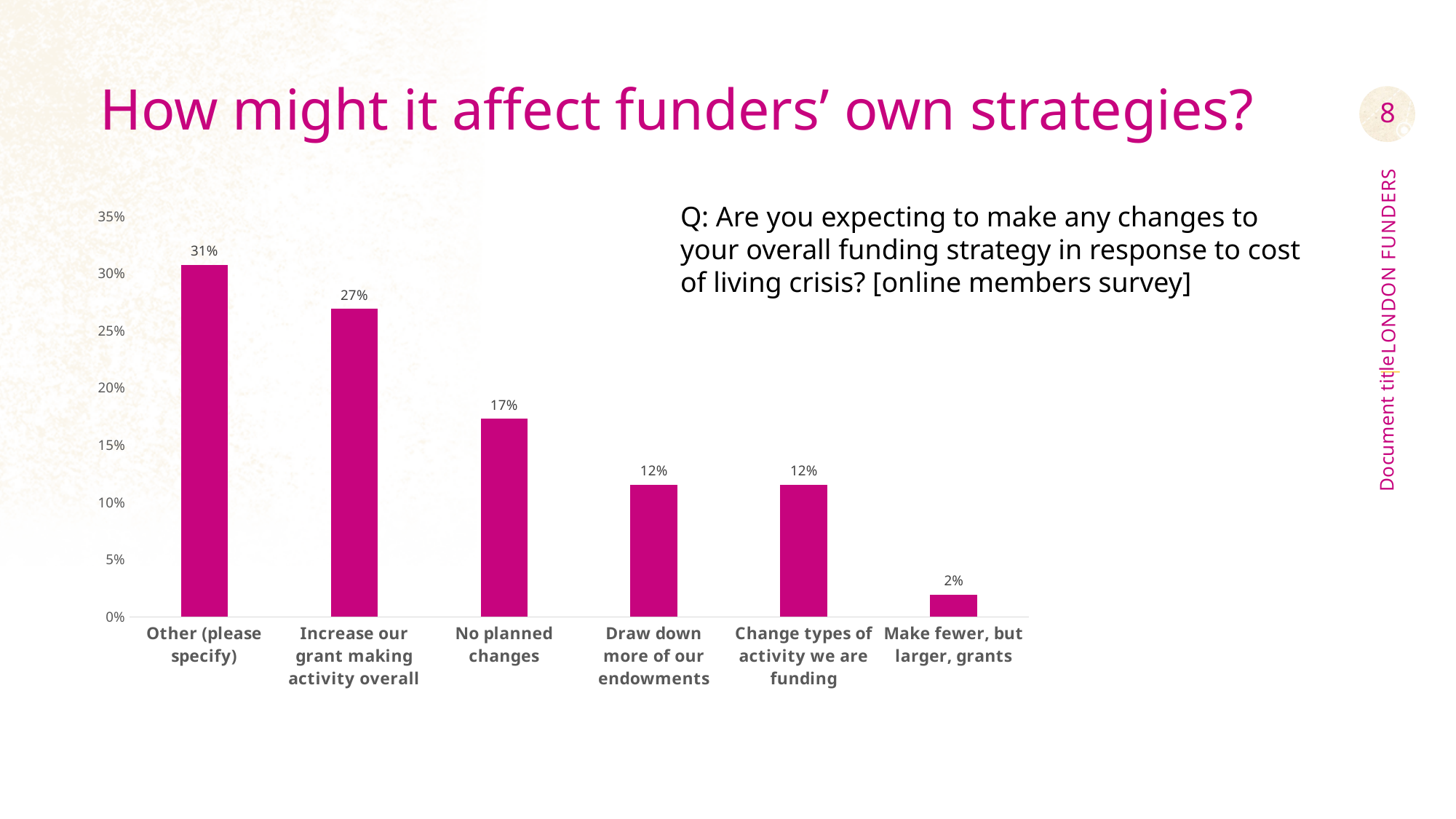
What is the difference between 'No planned changes' and 'Draw down more of our endowments'? 5% What percentage of respondents reported 'No planned changes'? 17% What is the difference between 'Other (please specify)' and 'Increase our grant making activity overall'? 4% What is the value for 'Increase our grant making activity overall'? 27% Do the values rise or fall moving from left to right along the x axis? Fall What is the value for 'Make fewer, but larger, grants'? 2% How many categories are shown in the chart? 6 Which is larger: 'Increase our grant making activity overall' or 'No planned changes'? Increase our grant making activity overall Which category has the highest value? Other (please specify) What type of chart is shown on the slide? Bar chart What percentage of respondents selected 'Other (please specify)'? 31% Which category has the lowest value? Make fewer, but larger, grants